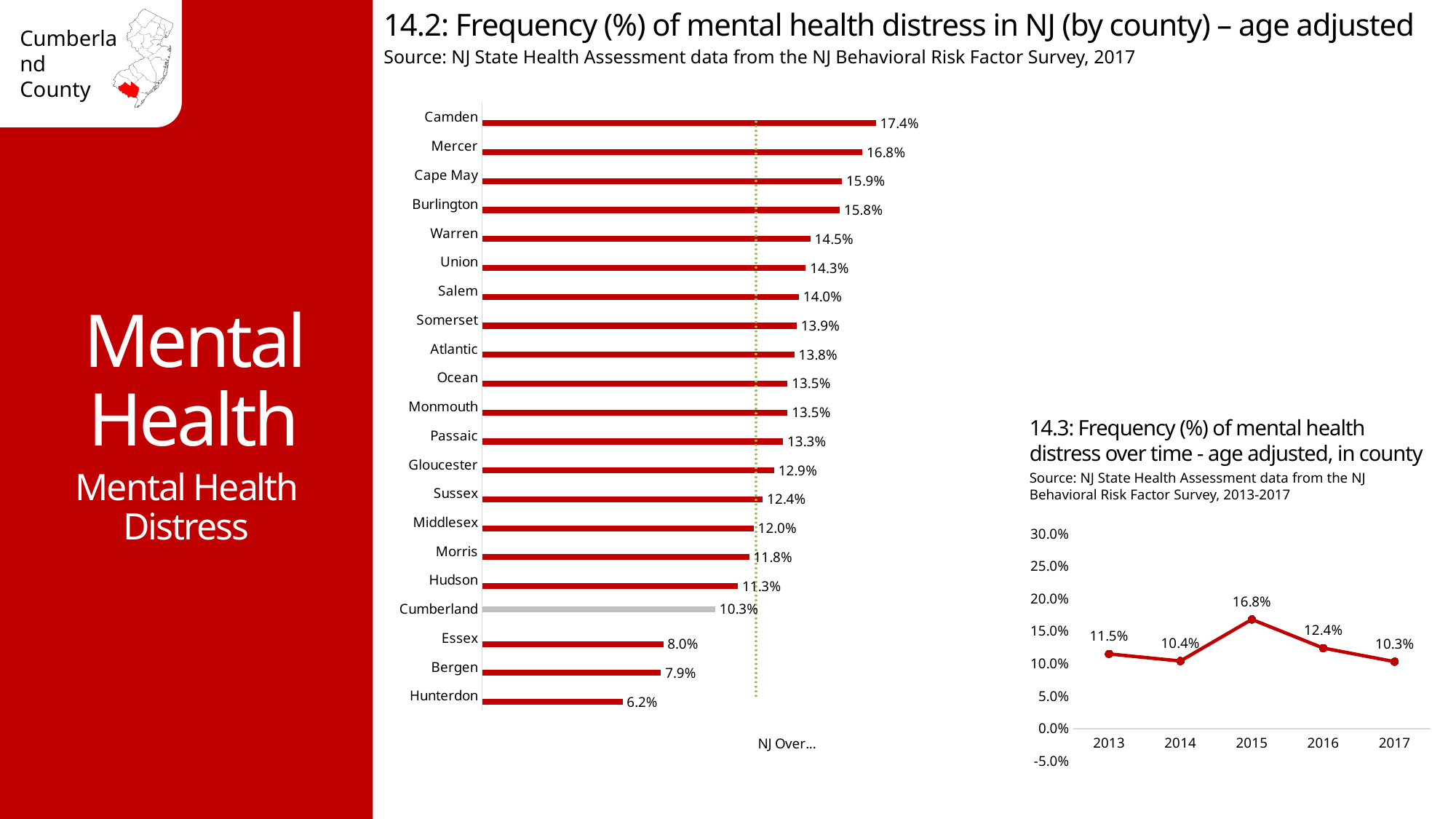
In chart 14.2 (mental health distress by county), which is larger, the value for Essex or the value for Bergen? Essex In chart 14.2 (mental health distress by county), which county has the lowest value? Hunterdon In chart 14.2 (mental health distress by county), how many counties are plotted? 21 In chart 14.3 (mental health distress over time), how many years are plotted? 5 In chart 14.3 (mental health distress over time), what is the value for 2015? 16.8% In chart 14.2 (mental health distress by county), which county has the highest value? Camden In chart 14.3 (mental health distress over time), what is the difference between 2015 and 2016? 4.4% In chart 14.2 (mental health distress by county), what is the difference between Camden and Hunterdon? 11.2% In chart 14.3 (mental health distress over time), which year has the lowest value? 2017 In chart 14.2 (mental health distress by county), what is the value for Cumberland? 10.3% What kind of chart is chart 14.2 (mental health distress by county)? Bar chart In chart 14.2 (mental health distress by county), what is the value for Camden? 17.4%